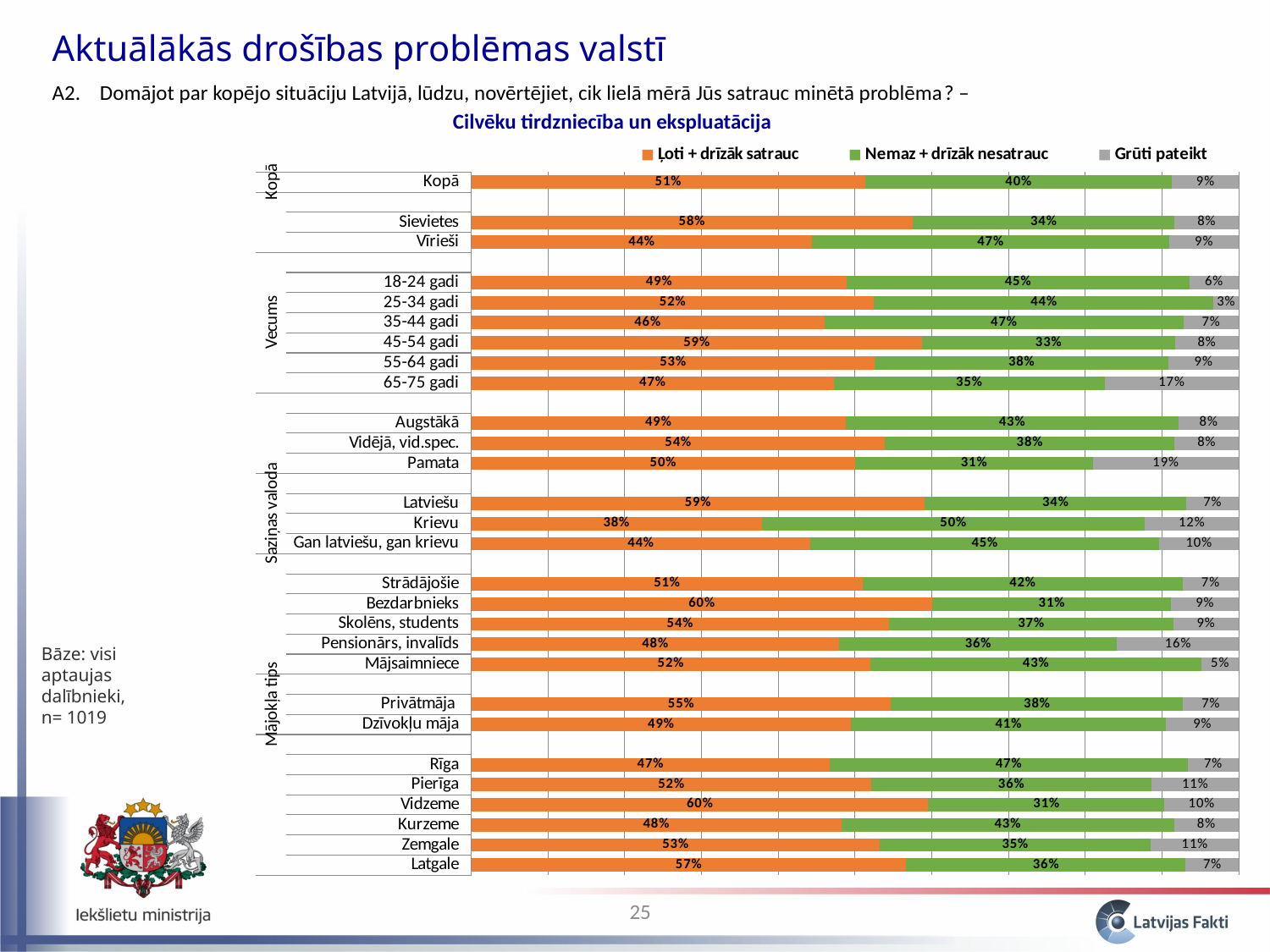
What is the difference between the "Ļoti + drīzāk satrauc" values for Sievietes and Vīrieši? 14% How many series does the legend list? 3 What is the value of "Grūti pateikt" for 65-75 gadi? 17% What is the value of "Nemaz + drīzāk nesatrauc" for Krievu? 50% What is the value of "Ļoti + drīzāk satrauc" for Kopā? 51% What is the total of the stacked bar for Kopā? 100% Which category has the lowest value for "Grūti pateikt"? 25-34 gadi Which category has the lowest value for "Ļoti + drīzāk satrauc"? Krievu Which category has the highest value for "Grūti pateikt"? Pamata Which has a larger "Ļoti + drīzāk satrauc" value, Latviešu or Krievu? Latviešu What is the title of the chart? Cilvēku tirdzniecība un ekspluatācija What kind of chart is shown on the slide? bar chart